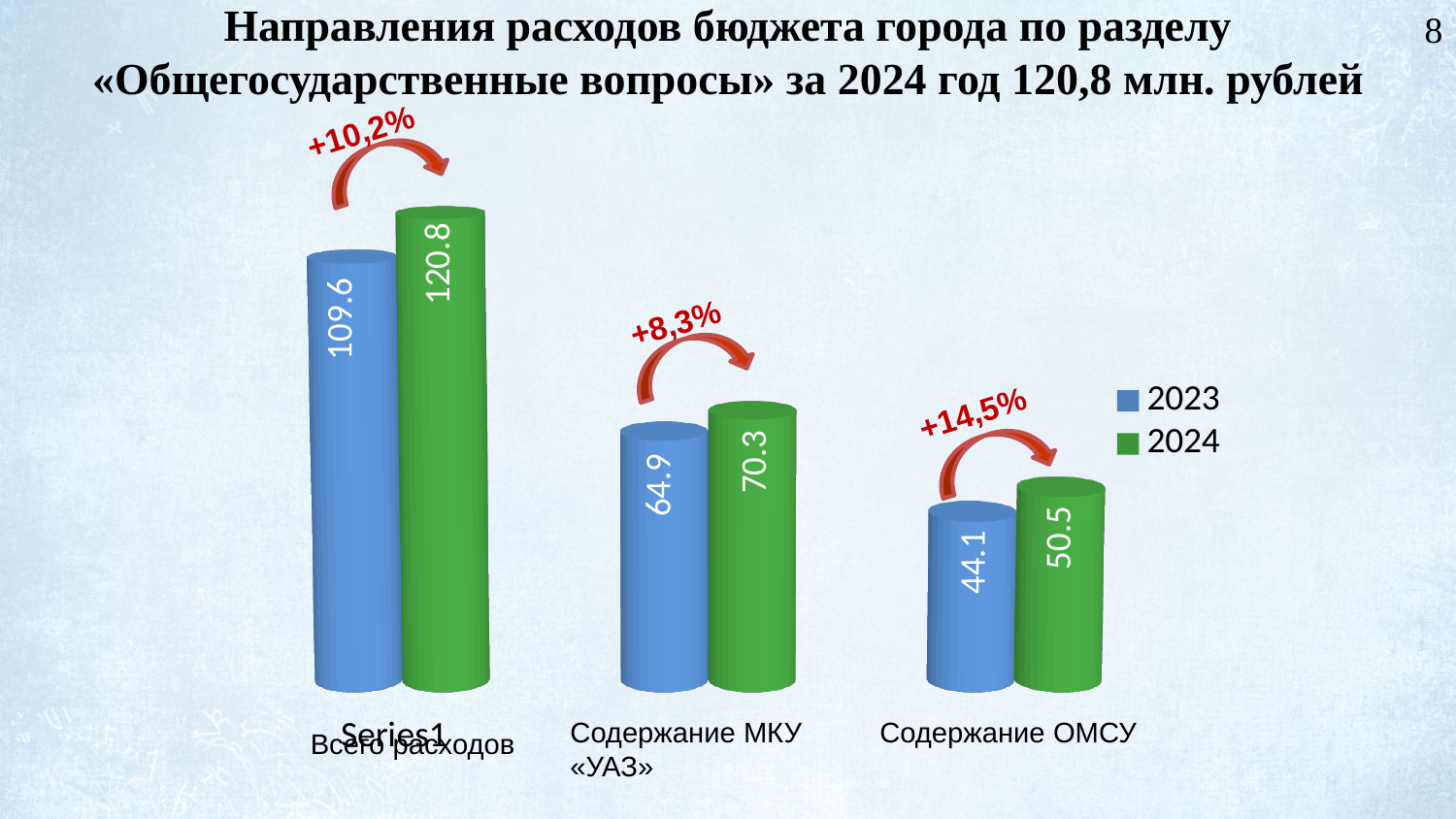
Which is larger for «Содержание МКУ «УАЗ»»: the 2023 value or the 2024 value? 2024 How many series does the legend list? 2 Which category has the highest value for 2024? Всего расходов What is the difference between the 2024 and 2023 values for «Содержание ОМСУ»? 6.4 Which category has the lowest value for 2023? Содержание ОМСУ What is the value for 2023 in the category «Содержание МКУ «УАЗ»»? 64.9 What is the value for 2024 in the category «Всего расходов»? 120.8 What is the value for 2024 in the category «Содержание ОМСУ»? 50.5 What is the difference between the 2024 and 2023 values for «Всего расходов»? 11.2 What is the value for 2023 in the category «Содержание ОМСУ»? 44.1 What kind of chart is shown on the slide? Bar chart What percentage change is shown above the bars for «Содержание ОМСУ»? +14,5%